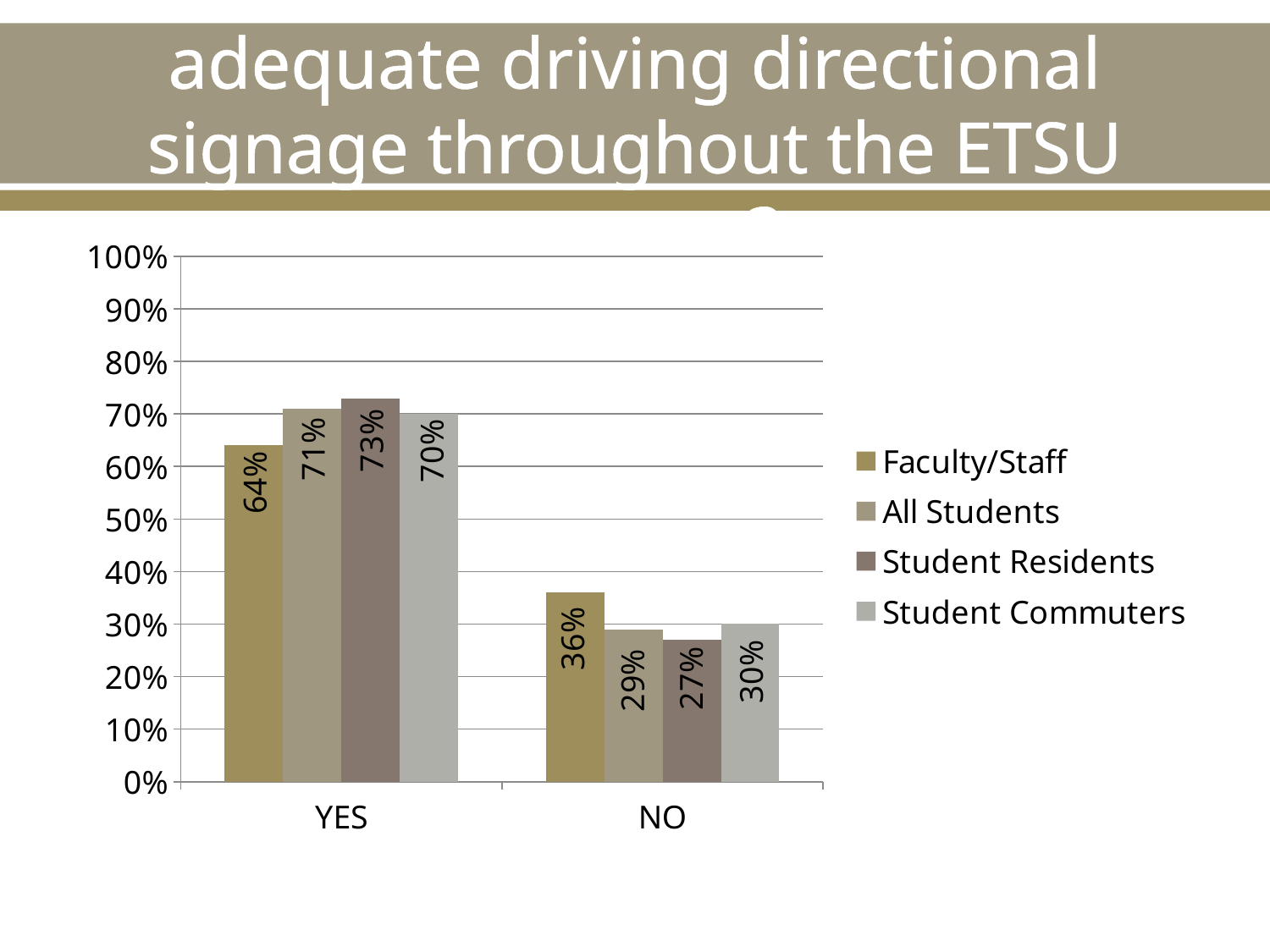
Which series has the lowest value in the NO category? Student Residents What is the total of the Student Residents values for YES and NO? 100% How many categories are shown on the x axis? 2 Which is larger: the All Students value for YES or the Student Commuters value for YES? All Students value for YES How many series does the legend list? 4 What is the value for All Students in the YES category? 71% What is the value for Faculty/Staff in the YES category? 64% What kind of chart is shown on the slide? Bar chart What is the value for Student Commuters in the NO category? 30% What is the value for Student Residents in the NO category? 27% Which series has the highest value in the YES category? Student Residents What is the difference between the Faculty/Staff values for YES and NO? 28%